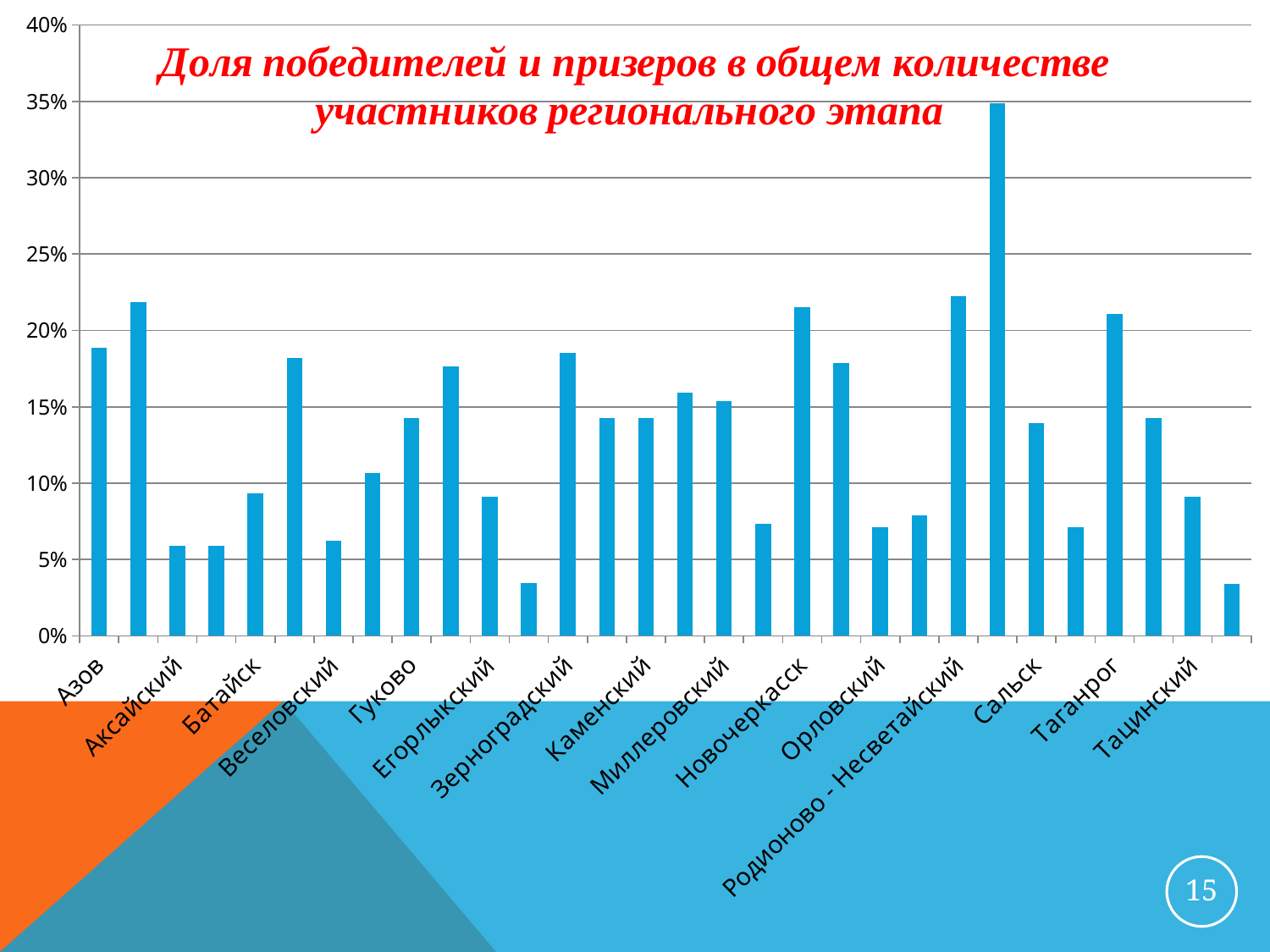
Is the value for Азов greater or less than 15%? greater What kind of chart is shown on the slide? bar chart Is the value for Аксайский greater or less than 10%? less Which has the larger value, Родионово - Несветайский or Сальск? Родионово - Несветайский Is the value for Новочеркасск greater or less than 20%? greater How many bars are plotted in the chart? 30 Which has the larger value, Азов or Аксайский? Азов What is the title of the chart? Доля победителей и призеров в общем количестве участников регионального этапа